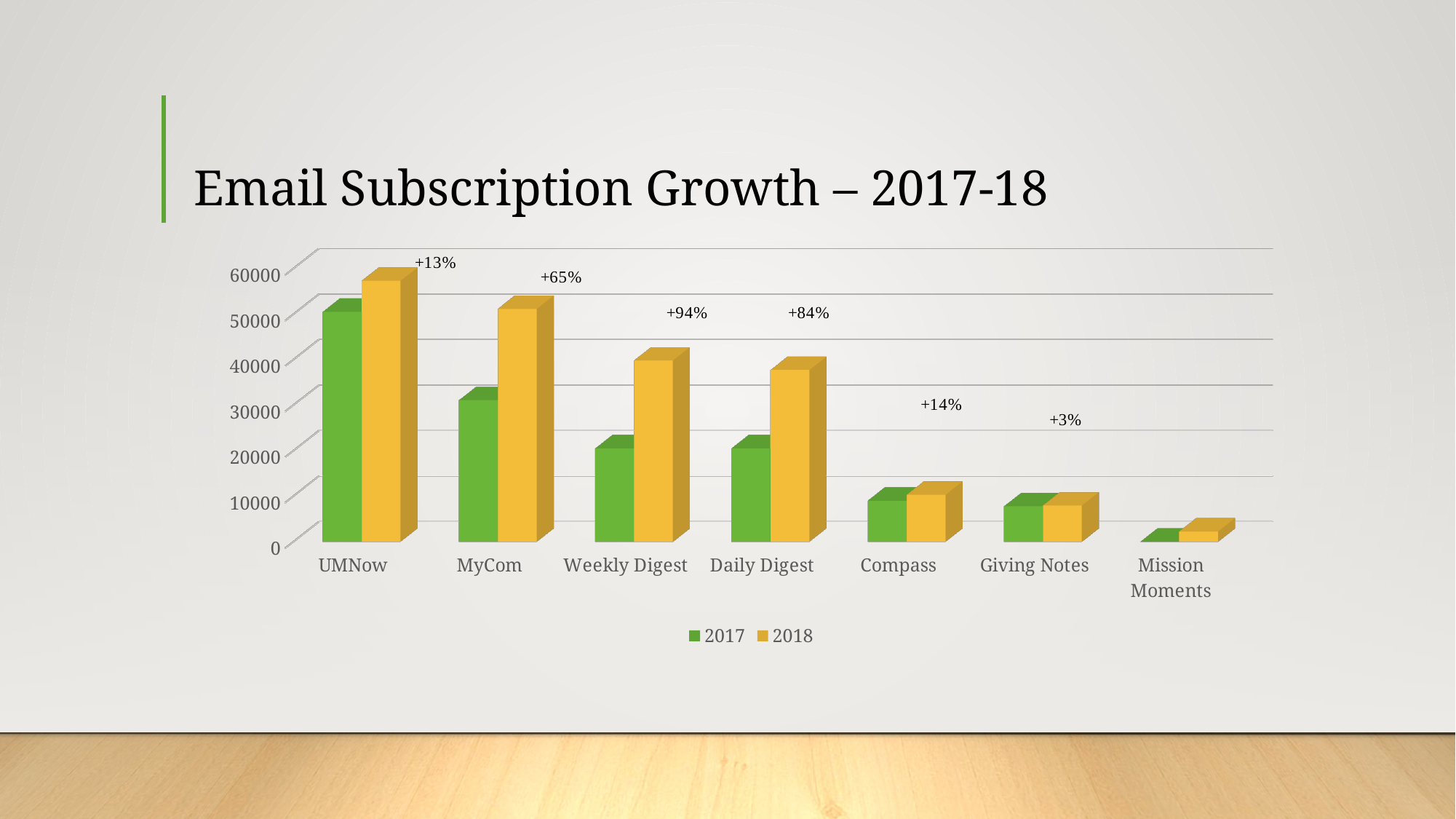
What growth percentage is printed above the Weekly Digest bars? +94% Which is larger, the 2018 value for MyCom or the 2018 value for Weekly Digest? MyCom How many series does the legend list? 2 What is the title of the slide's chart? Email Subscription Growth – 2017-18 What growth percentage is printed above the Giving Notes bars? +3% What kind of chart is shown on the slide? Bar chart Which category has the highest 2018 value? UMNow What growth percentage is printed above the MyCom bars? +65% Is the 2018 value for Daily Digest greater or less than 40000? less Which category has the lowest 2017 value? Mission Moments Do the 2018 values generally rise or fall moving from UMNow to Mission Moments along the x axis? fall How many email categories are shown on the x axis? 7